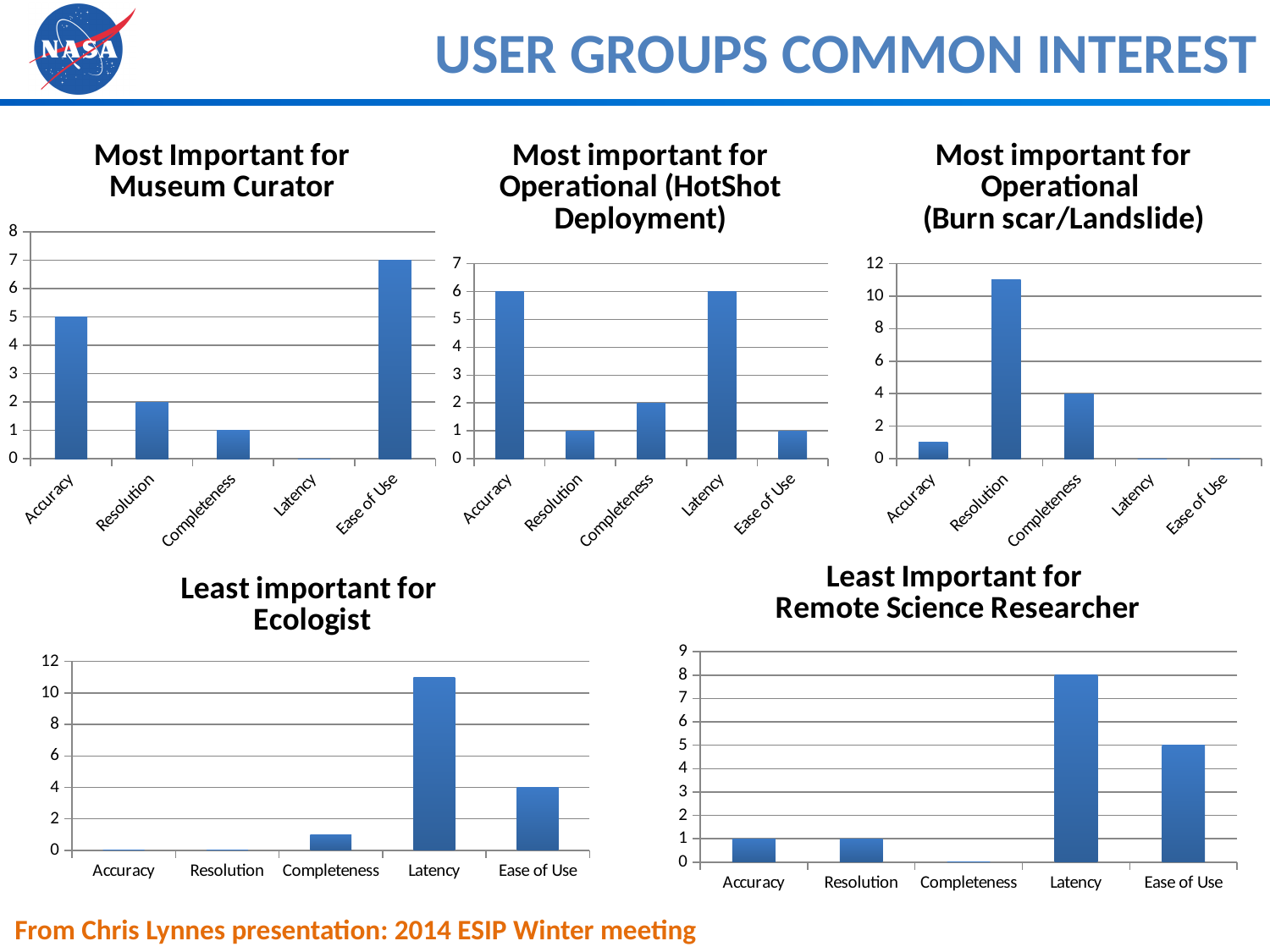
In the 'Least Important for Remote Science Researcher' chart, which is larger, Latency or Ease of Use? Latency In the 'Most Important for Museum Curator' chart, what is the value for Ease of Use? 7 How many categories are shown on the x axis of the 'Least important for Ecologist' chart? 5 In the 'Most important for Operational (HotShot Deployment)' chart, what is the value for Accuracy? 6 In the 'Least Important for Remote Science Researcher' chart, what is the value for Latency? 8 In the 'Most important for Operational (Burn scar/Landslide)' chart, is the value for Completeness greater or less than 6? less In the 'Most important for Operational (HotShot Deployment)' chart, what is the difference between Accuracy and Completeness? 4 In the 'Most Important for Museum Curator' chart, which category has the highest value? Ease of Use In the 'Least important for Ecologist' chart, which category has the highest value? Latency In the 'Least important for Ecologist' chart, what is the value for Ease of Use? 4 What type of chart is the 'Most Important for Museum Curator' chart? Bar chart